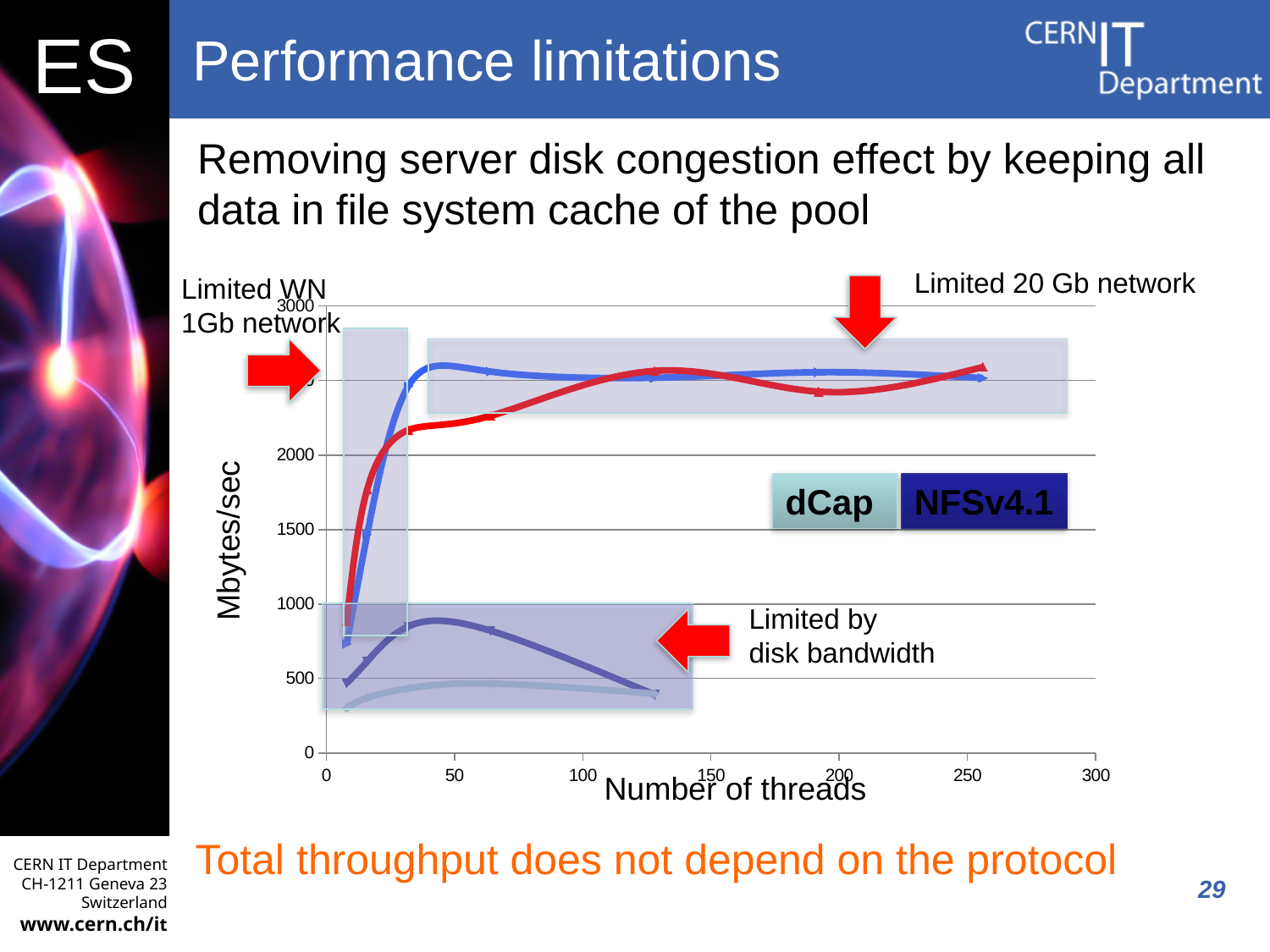
How many entries does the chart legend list? 2 What is the label of the x axis of the chart? Number of threads What is the label of the y axis of the chart? Mbytes/sec Which is higher at 50 threads: the blue NFSv4.1 line or the lower dark blue disk-limited line? the blue NFSv4.1 line Does the red dCap line rise or fall between 0 and 50 threads? rise What is the maximum value shown on the y axis of the chart? 3000 Is the peak value of the red dCap line greater or less than 2000 Mbytes/sec? greater Is the peak value of the lowest light blue line greater or less than 1000 Mbytes/sec? less What kind of chart is shown on the slide? line chart Does the lower dark blue line rise or fall between 50 and 125 threads? fall Is the peak value of the lower dark blue line (limited by disk bandwidth) greater or less than 1000 Mbytes/sec? less